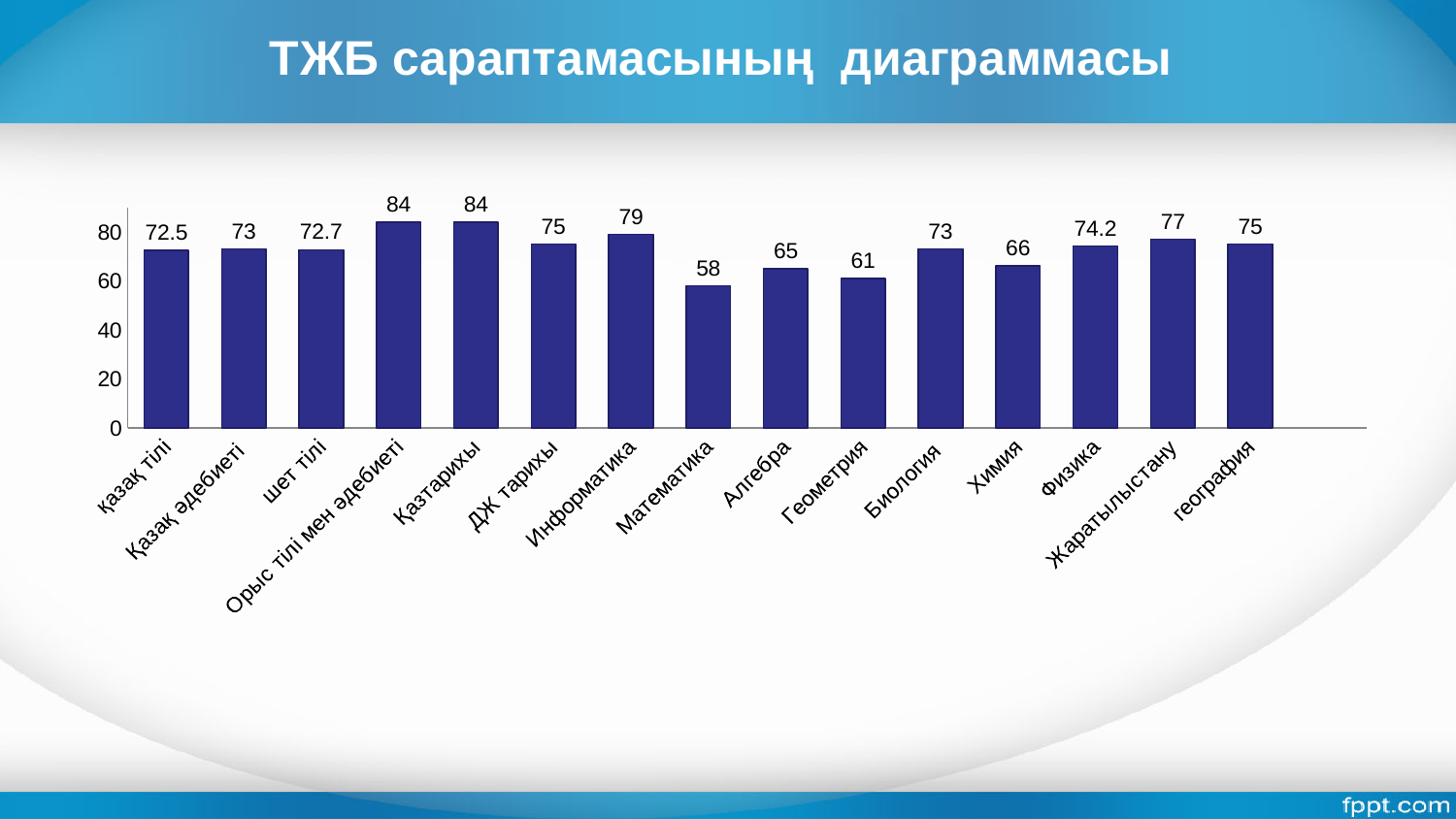
Which category has the lowest value? Математика What is the value for Физика? 74.2 What is the value for Математика? 58 What is the title of the slide? ТЖБ сараптамасының диаграммасы What is the value for шет тілі? 72.7 What is the value for Жаратылыстану? 77 How many categories are shown on the chart? 15 Is the value for Химия greater or less than 80? less Which is larger, the value for Алгебра or the value for Геометрия? Алгебра What is the highest value shown on the chart? 84 What kind of chart is shown on the slide? bar chart What is the difference between the values for Информатика and Математика? 21